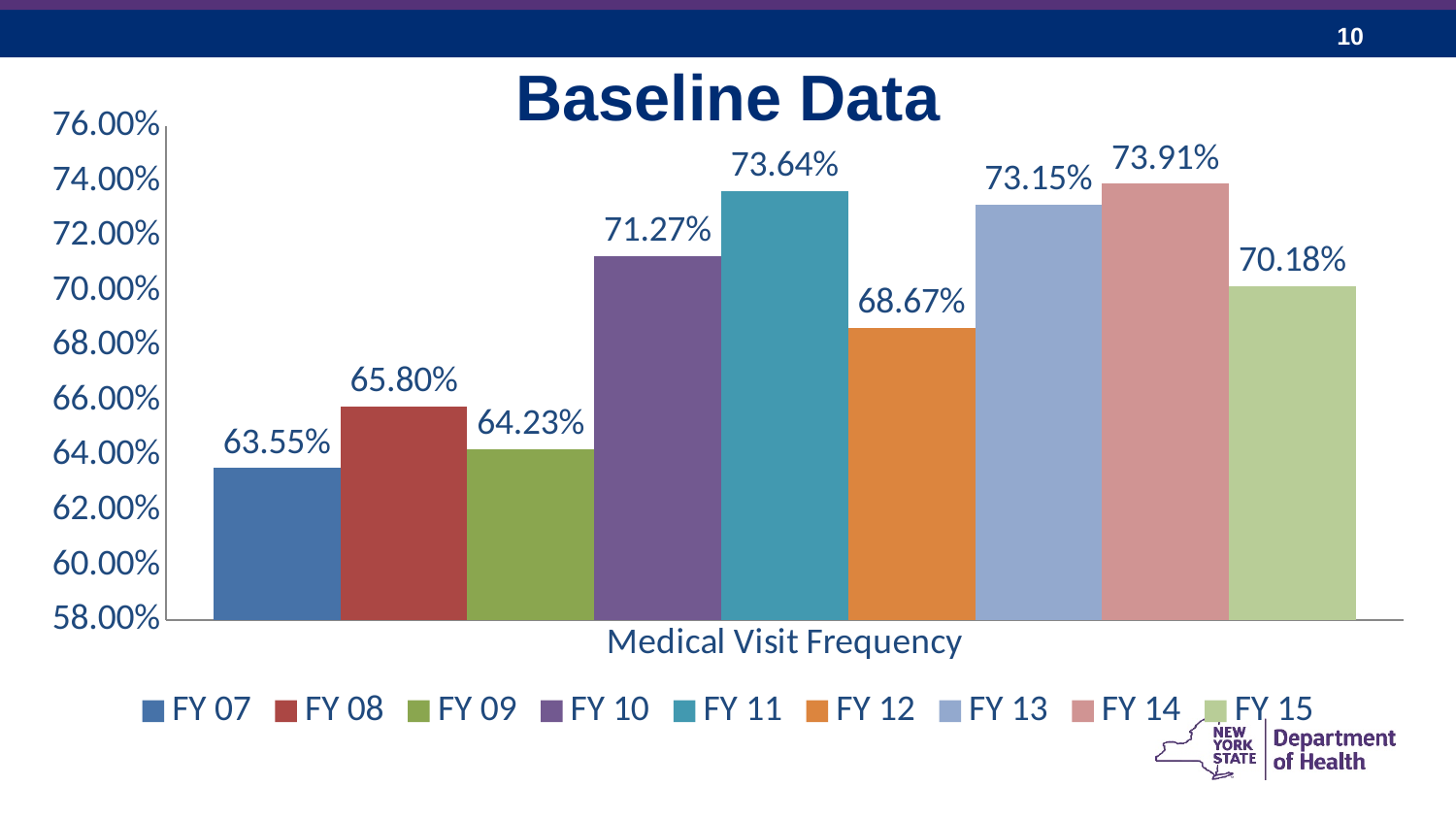
What is the Medical Visit Frequency value for FY 07? 63.55% Which fiscal year has the highest Medical Visit Frequency? FY 14 What is the Medical Visit Frequency value for FY 15? 70.18% Is the value for FY 13 greater or less than 72.00%? greater What kind of chart is shown on the slide? bar chart Which fiscal year has the lowest Medical Visit Frequency? FY 07 Which is larger, the value for FY 10 or the value for FY 12? FY 10 What is the title of the chart? Baseline Data What is the difference between the FY 14 and FY 07 values? 10.36% What is the difference between the FY 11 and FY 12 values? 4.97% How many fiscal years are plotted in the chart? 9 What is the Medical Visit Frequency value for FY 11? 73.64%